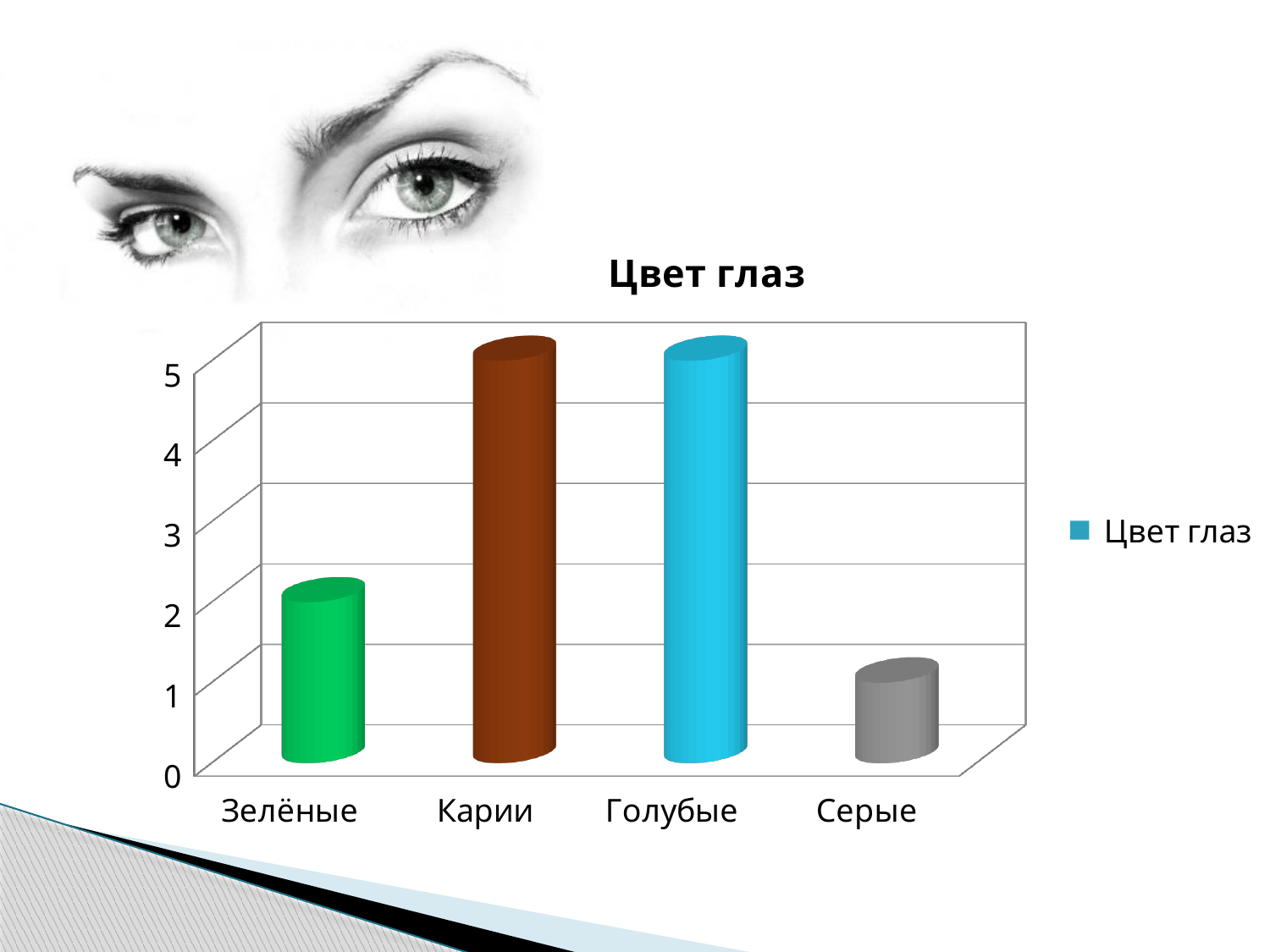
Is the value for Зелёные greater or less than 3? less Which category has the lowest value? Серые How many categories are shown on the x axis of the chart? 4 Is the value for Серые greater or less than 2? less Which is larger, the value for Голубые or the value for Серые? Голубые What is the name of the series listed in the legend? Цвет глаз How many series does the legend list? 1 What kind of chart is shown on the slide? bar chart Which is larger, the value for Карии or the value for Зелёные? Карии Which is larger, the value for Зелёные or the value for Серые? Зелёные Is the value for Карии greater or less than 4? greater What is the title of the chart? Цвет глаз